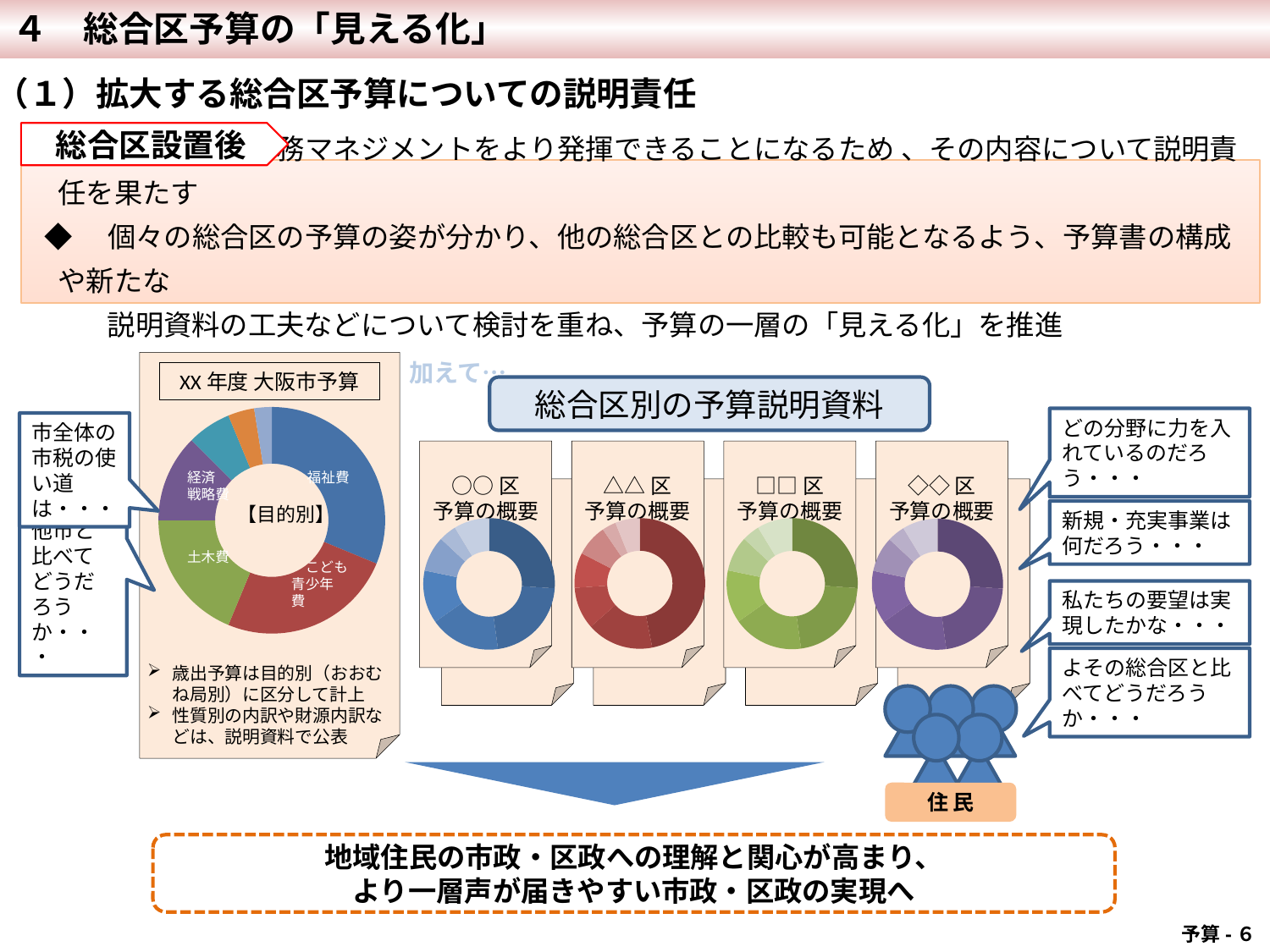
How many small donut charts are shown under the heading '総合区別の予算説明資料'? 4 What is the title shown above the donut chart on the left of the slide? XX 年度 大阪市予算 In the 'XX 年度 大阪市予算' chart, which slice is larger, こども青少年費 or 経済戦略費? こども青少年費 Which ward's donut chart under '総合区別の予算説明資料' is drawn in green? □□区 In the 'XX 年度 大阪市予算' chart, which slice is larger, 土木費 or 経済戦略費? 土木費 In the 'XX 年度 大阪市予算' chart, which labeled category has the largest slice? 福祉費 Which ward's donut chart under '総合区別の予算説明資料' is drawn in purple? ◇◇区 In the 'XX 年度 大阪市予算' chart, which slice is larger, 福祉費 or 土木費? 福祉費 What kind of chart is the 'XX 年度 大阪市予算' chart on the left of the slide? Donut (pie) chart What label is printed in the center of the 'XX 年度 大阪市予算' donut chart? 【目的別】